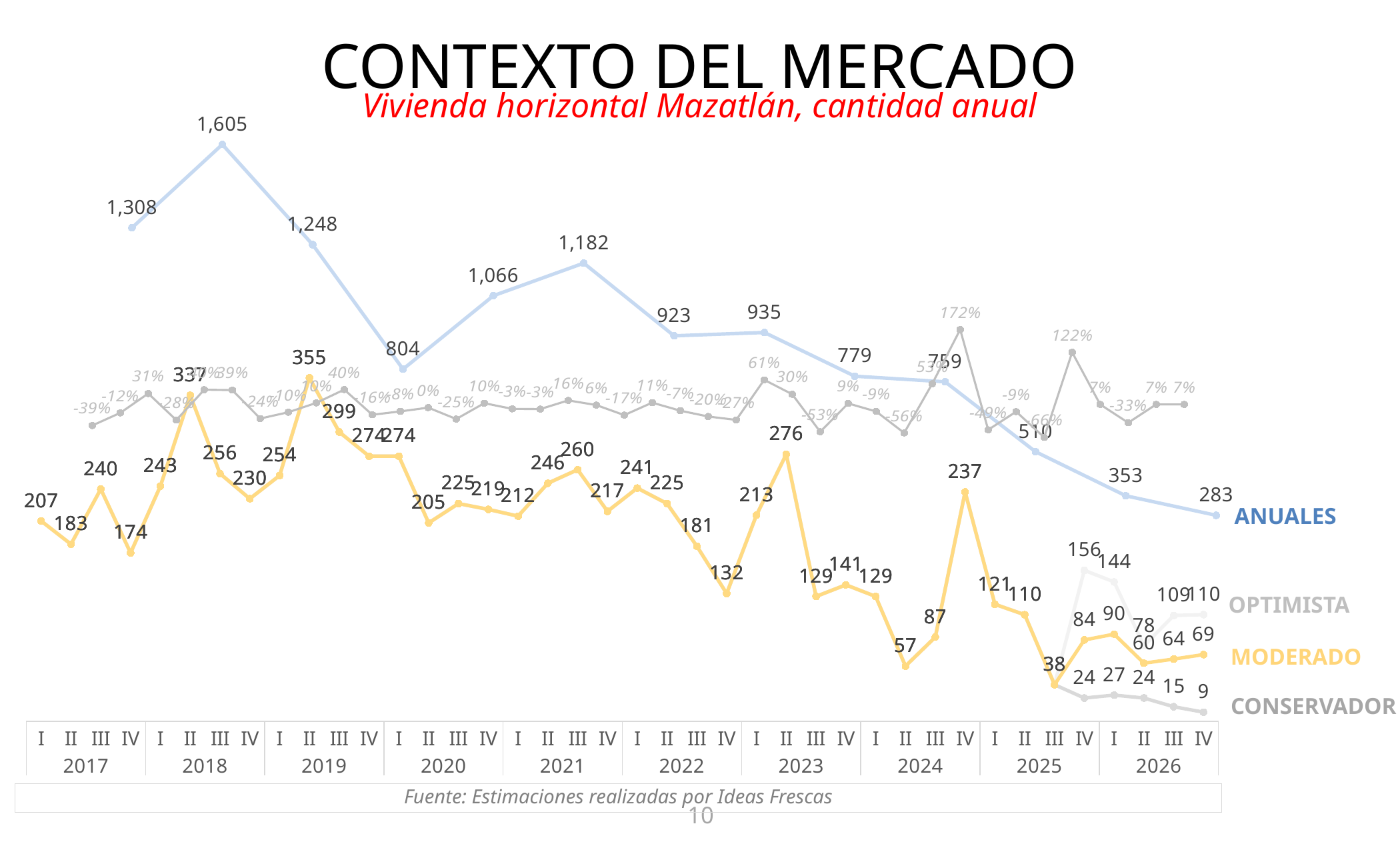
What is the value for quarter IV of 2024 on the yellow line? 237 How many years are labelled on the x axis? 10 Which is larger: the value for quarter II of 2023 or the value for quarter I of 2022? Quarter II of 2023 (276) What is the highest value on the ANUALES line? 1,605 What is the lowest value on the ANUALES line? 283 What is the CONSERVADOR value for quarter IV of 2026? 9 What type of chart is shown on the slide? Line chart What is the value for quarter II of 2024 on the yellow line? 57 What is the OPTIMISTA value for quarter IV of 2025? 156 What is the highest quarterly value shown on the yellow line, and in which quarter does it occur? 355, 2019 II What is the difference between the values for quarter IV of 2024 (237) and quarter III of 2024 (87)? 150 What source is cited below the chart? Estimaciones realizadas por Ideas Frescas